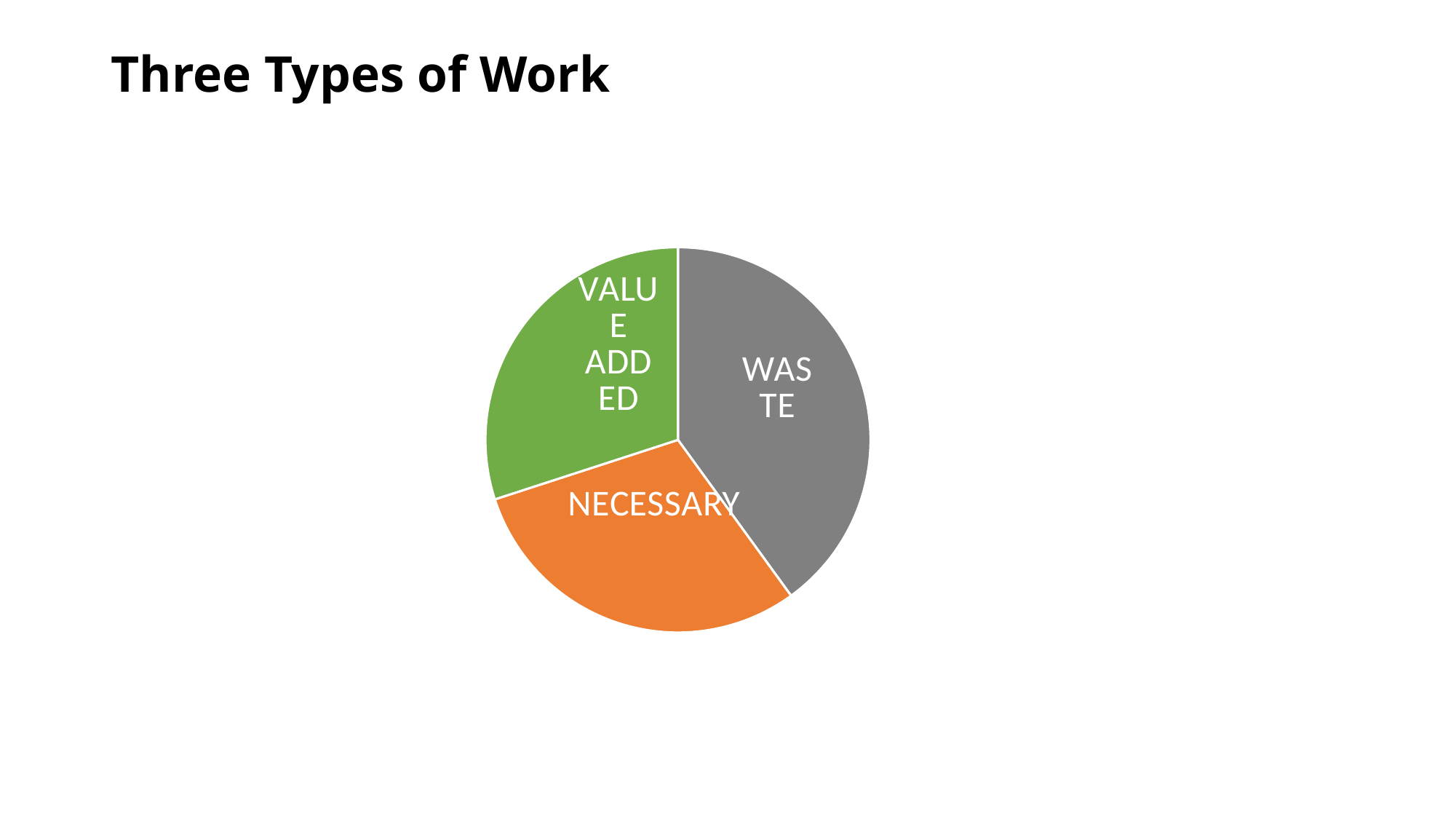
What kind of chart is shown on the slide? Pie chart Which slice is larger, WASTE or NECESSARY? WASTE Which slice is larger, WASTE or VALUE ADDED? WASTE How many slices does the pie chart have? 3 What is the title of the slide containing the pie chart? Three Types of Work Which slice of the pie chart is the largest? WASTE Which slice of the pie chart is coloured green? VALUE ADDED